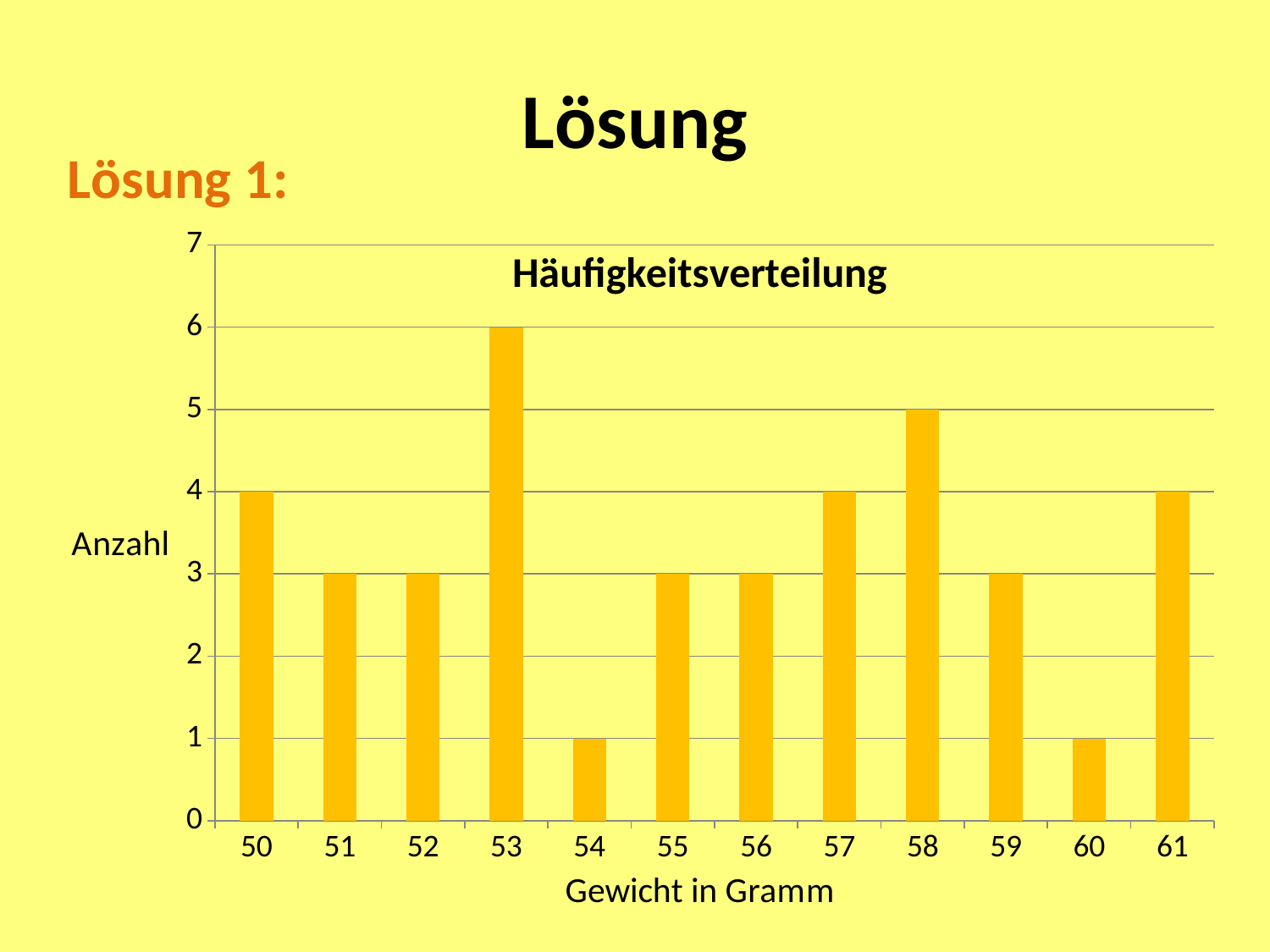
How many weight categories are shown on the x axis? 12 What is the difference between the values for 53 grams and 58 grams? 1 What is the value for 61 grams? 4 What is the value for 54 grams? 1 What is the difference between the values for 53 grams and 54 grams? 5 Which is larger, the value for 58 grams or the value for 57 grams? 58 grams What is the title of the chart? Häufigkeitsverteilung What kind of chart is shown? bar chart Which weight category has the highest count? 53 Is the value for 53 grams greater or less than 5? greater What is the value for 58 grams? 5 What is the value for 53 grams? 6